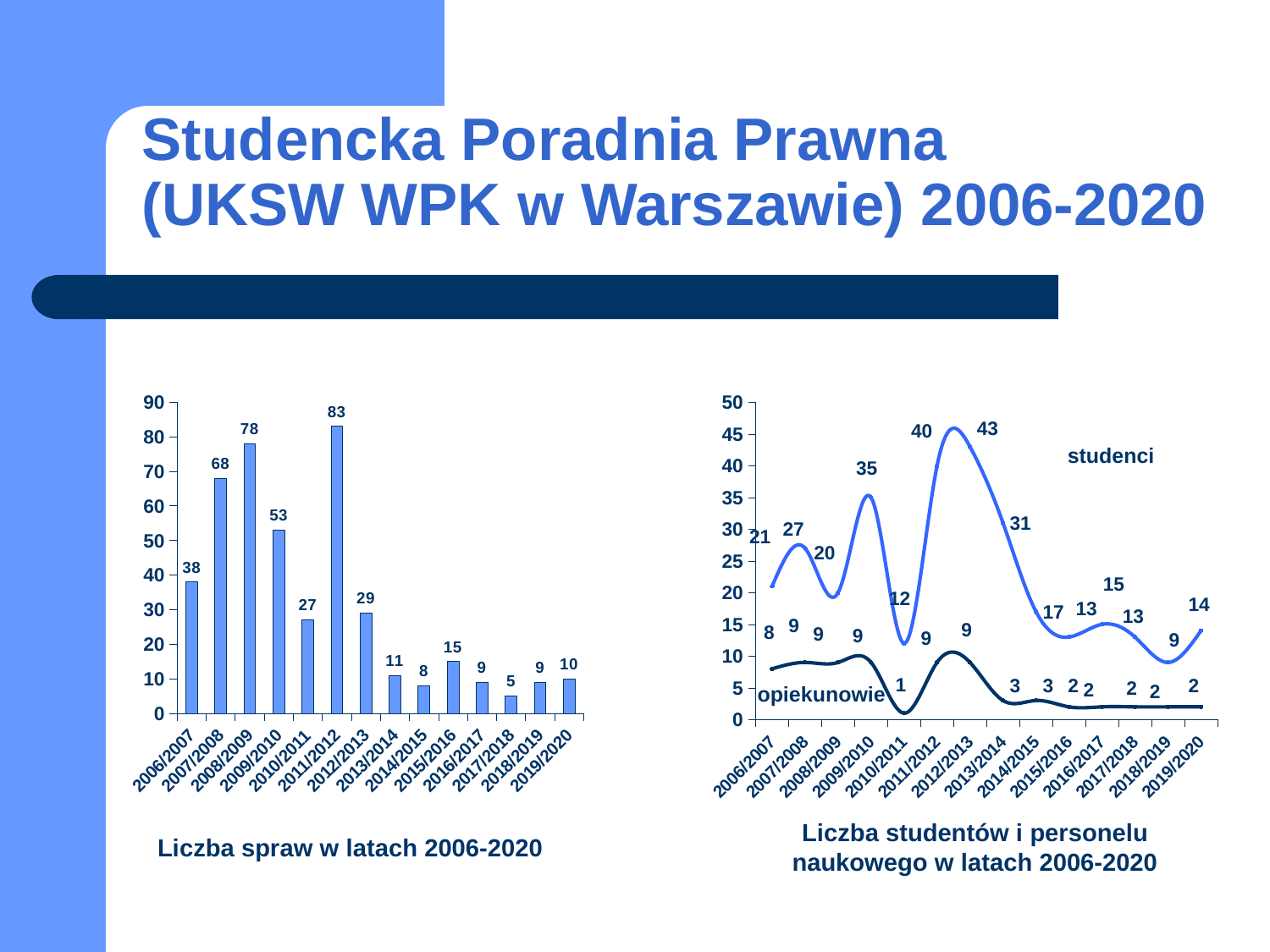
In the chart 'Liczba spraw w latach 2006-2020', what is the value for 2011/2012? 83 In the chart 'Liczba studentów i personelu naukowego w latach 2006-2020', what is the difference between studenci and opiekunowie in 2011/2012? 31 In the chart 'Liczba studentów i personelu naukowego w latach 2006-2020', which year has the highest value for studenci? 2012/2013 In the chart 'Liczba studentów i personelu naukowego w latach 2006-2020', which is larger in 2013/2014: studenci or opiekunowie? studenci In the chart 'Liczba studentów i personelu naukowego w latach 2006-2020', what is the value for opiekunowie in 2010/2011? 1 What kind of chart is 'Liczba studentów i personelu naukowego w latach 2006-2020'? line chart What kind of chart is 'Liczba spraw w latach 2006-2020'? bar chart In the chart 'Liczba spraw w latach 2006-2020', how many years are shown on the x axis? 14 In the chart 'Liczba spraw w latach 2006-2020', what is the difference between the values for 2008/2009 and 2009/2010? 25 In the chart 'Liczba spraw w latach 2006-2020', which year has the highest value? 2011/2012 In the chart 'Liczba studentów i personelu naukowego w latach 2006-2020', what is the value for studenci in 2012/2013? 43 In the chart 'Liczba spraw w latach 2006-2020', which year has the lowest value? 2017/2018